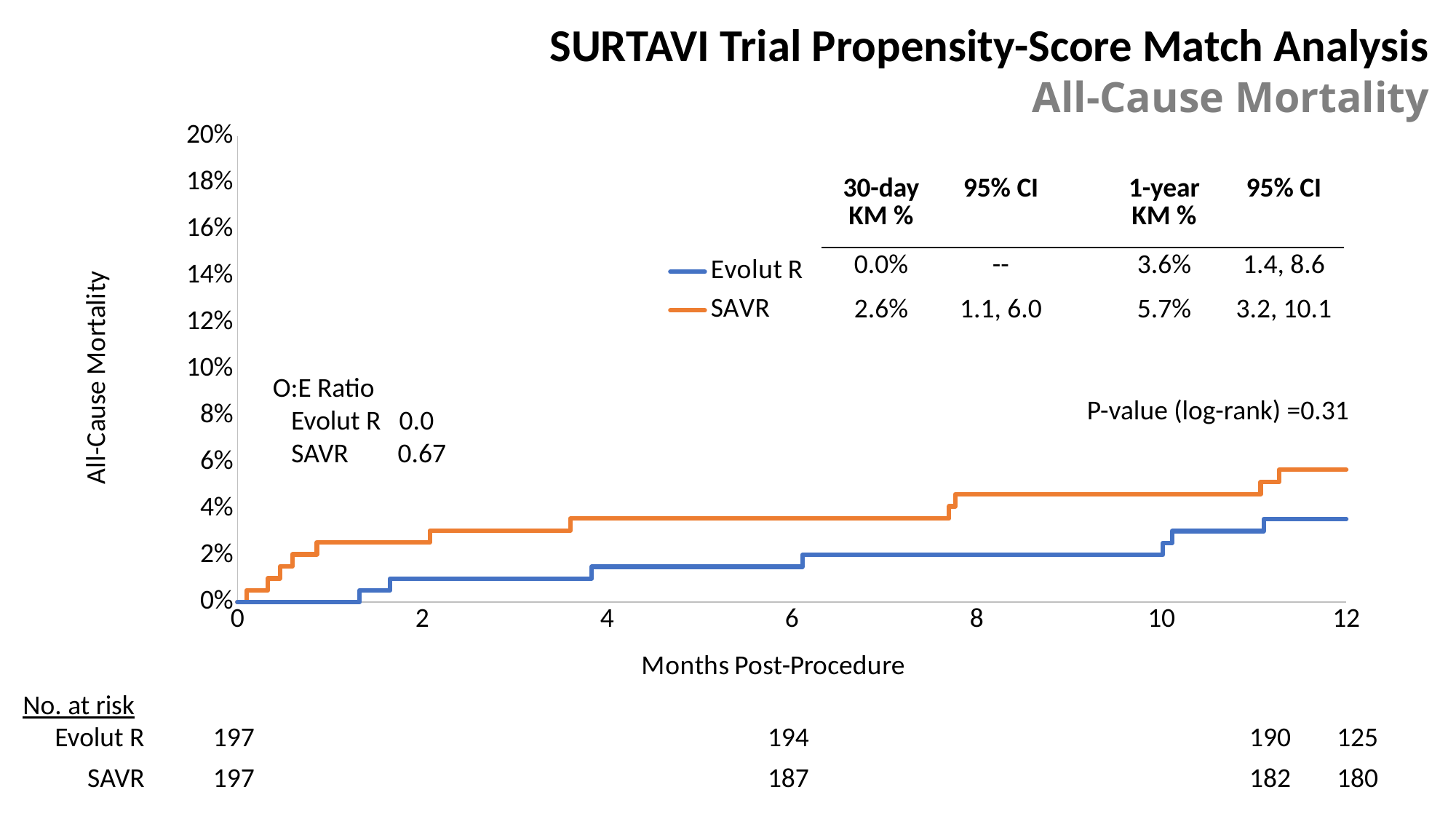
What is the 1-year KM % for Evolut R? 3.6% What is the log-rank P-value shown on the chart? 0.31 What is the 1-year KM % for SAVR? 5.7% What kind of chart is shown on the slide? line chart Which group has the higher 1-year KM % mortality, Evolut R or SAVR? SAVR What is the O:E Ratio for SAVR? 0.67 Do the mortality curves rise or fall as months post-procedure increase? rise What is the number at risk for Evolut R at 12 months? 125 How many series does the legend list? 2 What is the difference between the 1-year KM % for SAVR and for Evolut R? 2.1% Is the Evolut R curve at 6 months greater or less than 2%? less What is the 30-day KM % for SAVR? 2.6%